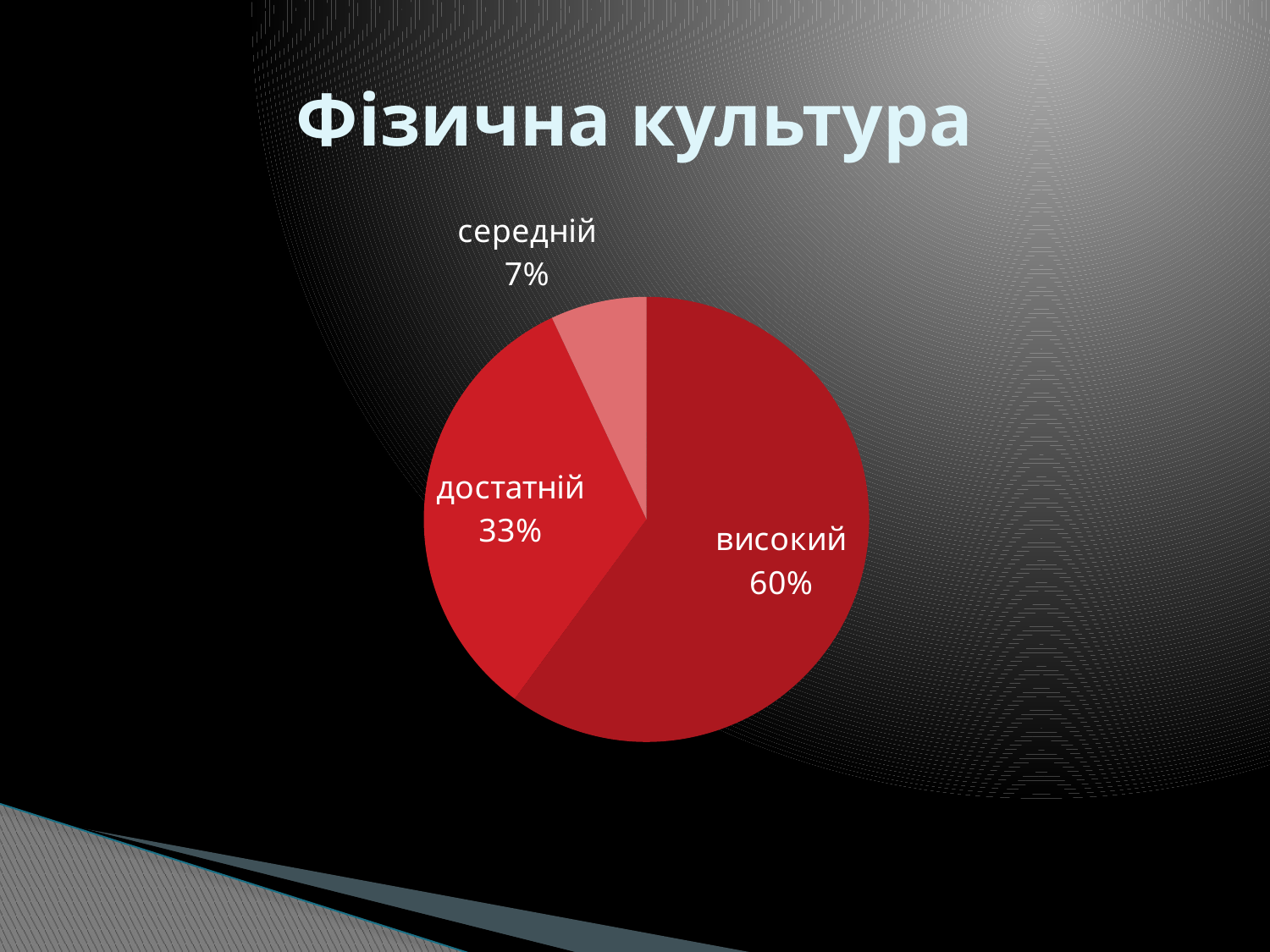
Which category has the largest slice of the pie? високий What share of the pie does the "середній" slice represent? 7% What kind of chart is shown on the slide? pie chart What is the difference in percentage points between the "високий" and "достатній" slices? 27 What share of the pie does the "достатній" slice represent? 33% What is the difference in percentage points between the "достатній" and "середній" slices? 26 Which category has the smallest slice of the pie? середній What is the title of the slide containing the chart? Фізична культура Which slice is larger, "високий" or "достатній"? високий What share of the pie does the "високий" slice represent? 60% Which slice is larger, "достатній" or "середній"? достатній How many slices does the pie chart have? 3